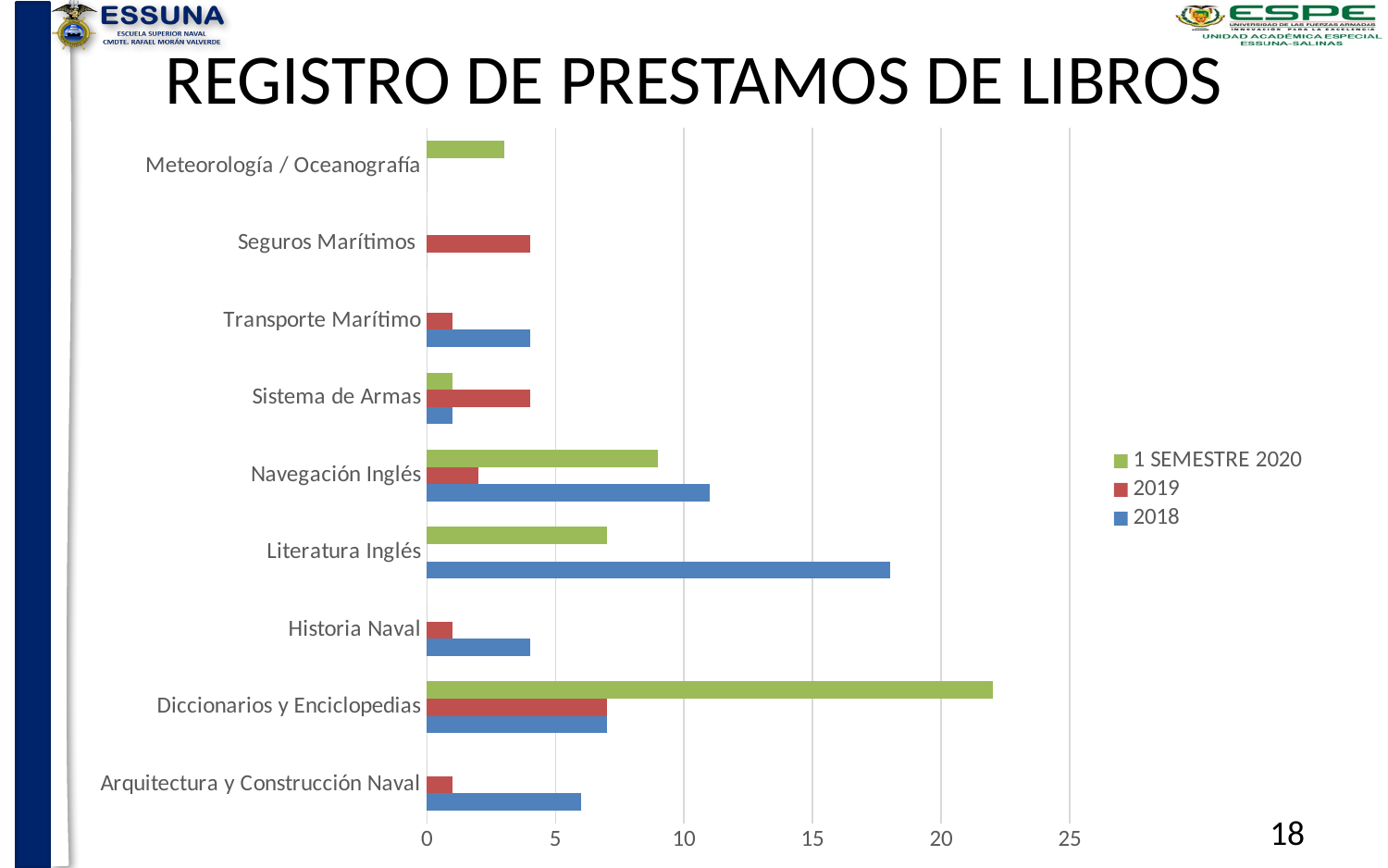
What type of chart is shown on the slide? bar chart Is the 2018 value for Navegación Inglés greater or less than 10? greater Is the 2018 value for Literatura Inglés greater or less than 15? greater How many series does the legend list? 3 For Literatura Inglés, which series has the larger value: 2018 or 1 SEMESTRE 2020? 2018 Is the 1 SEMESTRE 2020 value for Diccionarios y Enciclopedias greater or less than 20? greater Which category has the longest bar for the 1 SEMESTRE 2020 series? Diccionarios y Enciclopedias What is the title of the chart on the slide? REGISTRO DE PRESTAMOS DE LIBROS For Navegación Inglés, which series has the larger value: 2019 or 1 SEMESTRE 2020? 1 SEMESTRE 2020 Which category has the longest bar for the 2018 series? Literatura Inglés How many categories are shown on the vertical axis of the chart? 9